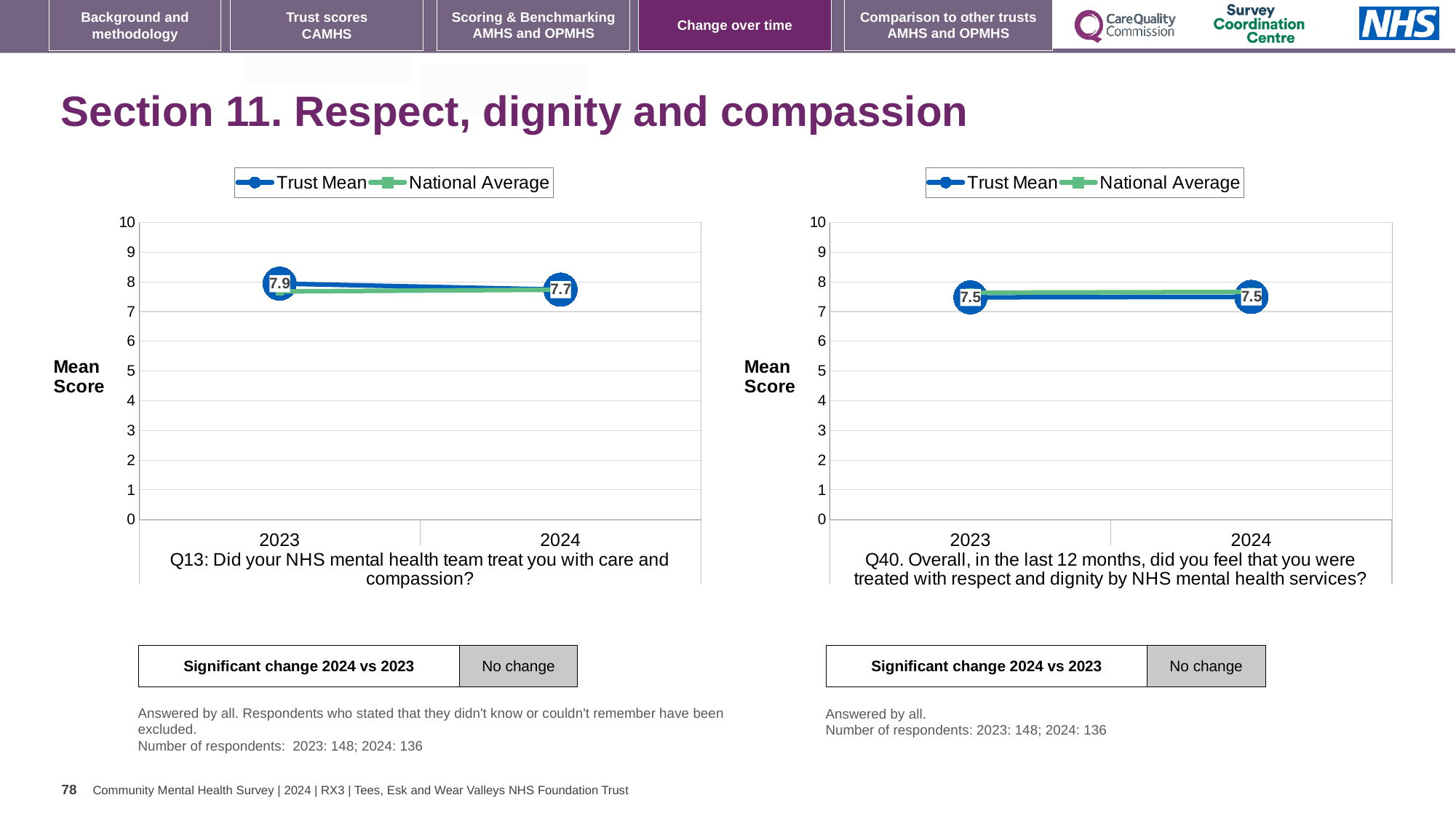
In the right chart (Q40), is the National Average for 2023 greater or less than 5? greater In the left chart (Q13), does the Trust Mean rise or fall from 2023 to 2024? fall In the left chart (Q13), which year has the higher Trust Mean, 2023 or 2024? 2023 What kind of chart is the left chart (Q13)? line chart In the left chart (Q13), what is the difference between the Trust Mean for 2023 and 2024? 0.2 How many series does the legend of the right chart (Q40) list? 2 In the left chart (Q13), what is the Trust Mean for 2023? 7.9 In the right chart (Q40), does the Trust Mean rise, fall or stay the same from 2023 to 2024? stay the same In the right chart (Q40), what is the Trust Mean for 2024? 7.5 What is the label on the y axis of the left chart (Q13)? Mean Score In the left chart (Q13), what is the Trust Mean for 2024? 7.7 How many years are plotted on the x axis of the left chart (Q13)? 2